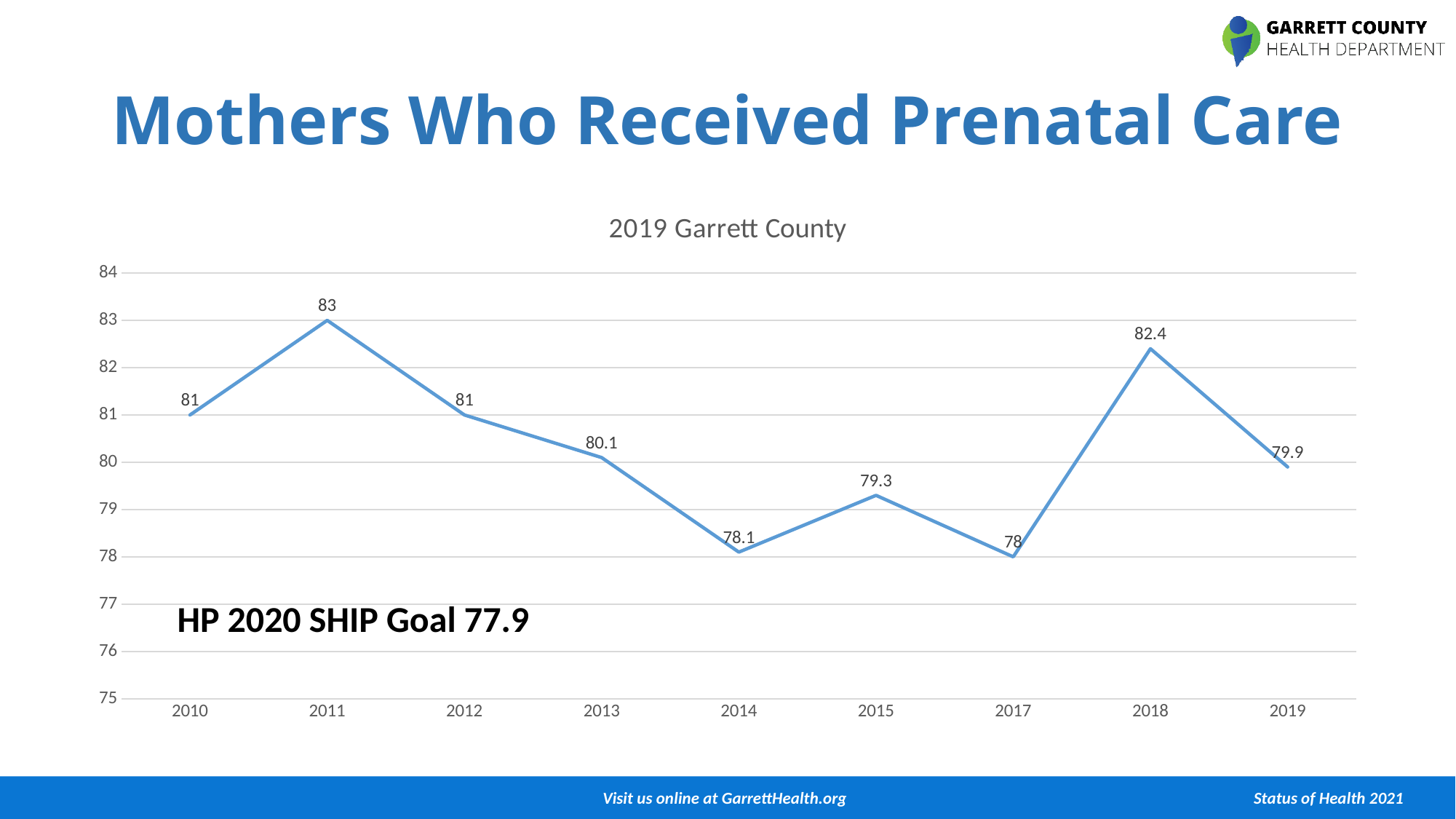
Which year has the lowest value? 2017 How many years are plotted on the chart? 9 What is the chart's title? 2019 Garrett County What is the value for 2014? 78.1 What is the value for 2018? 82.4 What is the difference between the values for 2011 and 2017? 5 Which is larger, the value for 2015 or the value for 2019? 2019 Is the value for 2013 greater or less than 80? greater Which year has the highest value? 2011 What is the value for 2011? 83 What is the value for 2019? 79.9 What kind of chart is shown? line chart